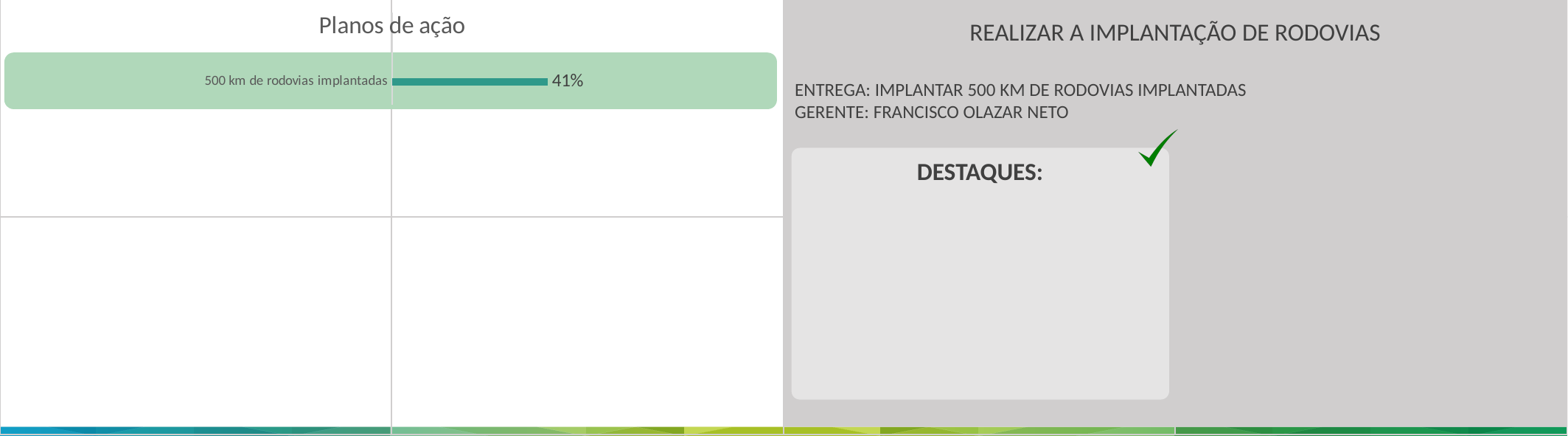
Is the bar in the Planos de ação chart oriented horizontally or vertically? Horizontally What kind of chart is shown under the title Planos de ação? Bar chart What is the label of the single category plotted in the Planos de ação chart? 500 km de rodovias implantadas What is the title of the chart on the left side of the slide? Planos de ação What is the value shown for "500 km de rodovias implantadas" in the Planos de ação chart? 41% How many categories are plotted in the Planos de ação chart? 1